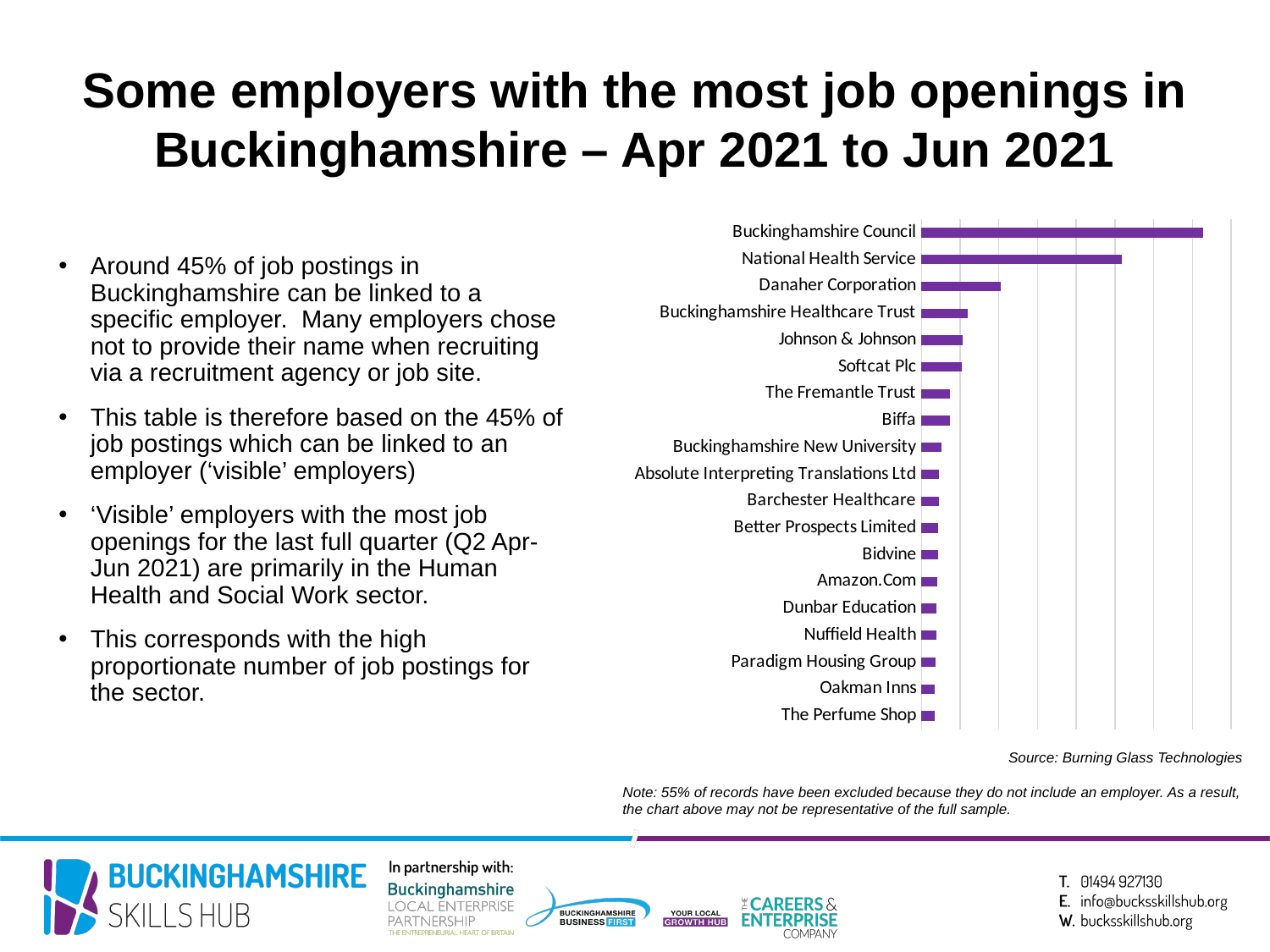
Which has the longer bar, Danaher Corporation or Buckinghamshire Healthcare Trust? Danaher Corporation What colour are the bars in the chart? Purple What type of chart is shown on the slide? Bar chart Which has the longer bar, National Health Service or Danaher Corporation? National Health Service Which employer is listed at the bottom of the chart? The Perfume Shop Which has the longer bar, Buckinghamshire Healthcare Trust or Biffa? Buckinghamshire Healthcare Trust Which employer has the highest number of job openings in the chart? Buckinghamshire Council Which employer has the third-longest bar in the chart? Danaher Corporation Which employer has the second-longest bar in the chart? National Health Service How many employers are listed in the chart? 19 Do the bar lengths increase or decrease going from the top of the chart to the bottom? Decrease